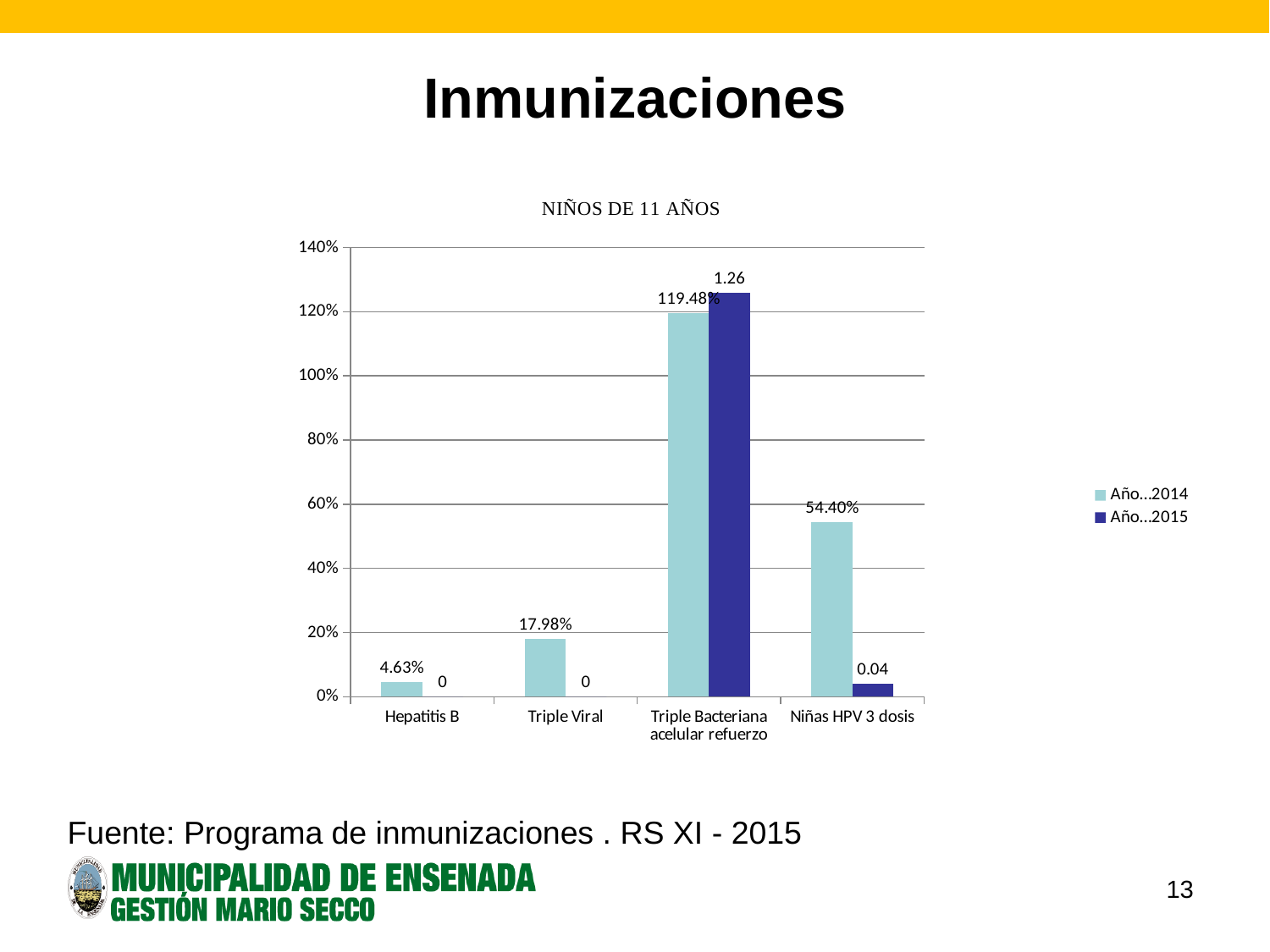
What is the Año...2014 value for Triple Viral? 17.98% Which category has the lowest Año...2014 value? Hepatitis B What is the title of the chart? NIÑOS DE 11 AÑOS What is the Año...2014 value for Triple Bacteriana acelular refuerzo? 119.48% What is the Año...2015 data label for Triple Bacteriana acelular refuerzo? 1.26 What is the Año...2014 value for Hepatitis B? 4.63% Which is larger for Año...2014: Triple Viral or Niñas HPV 3 dosis? Niñas HPV 3 dosis What is the Año...2014 value for Niñas HPV 3 dosis? 54.40% What type of chart is shown on the slide? bar chart Which category has the highest Año...2014 value? Triple Bacteriana acelular refuerzo How many series does the legend list? 2 How many categories are shown on the x axis? 4